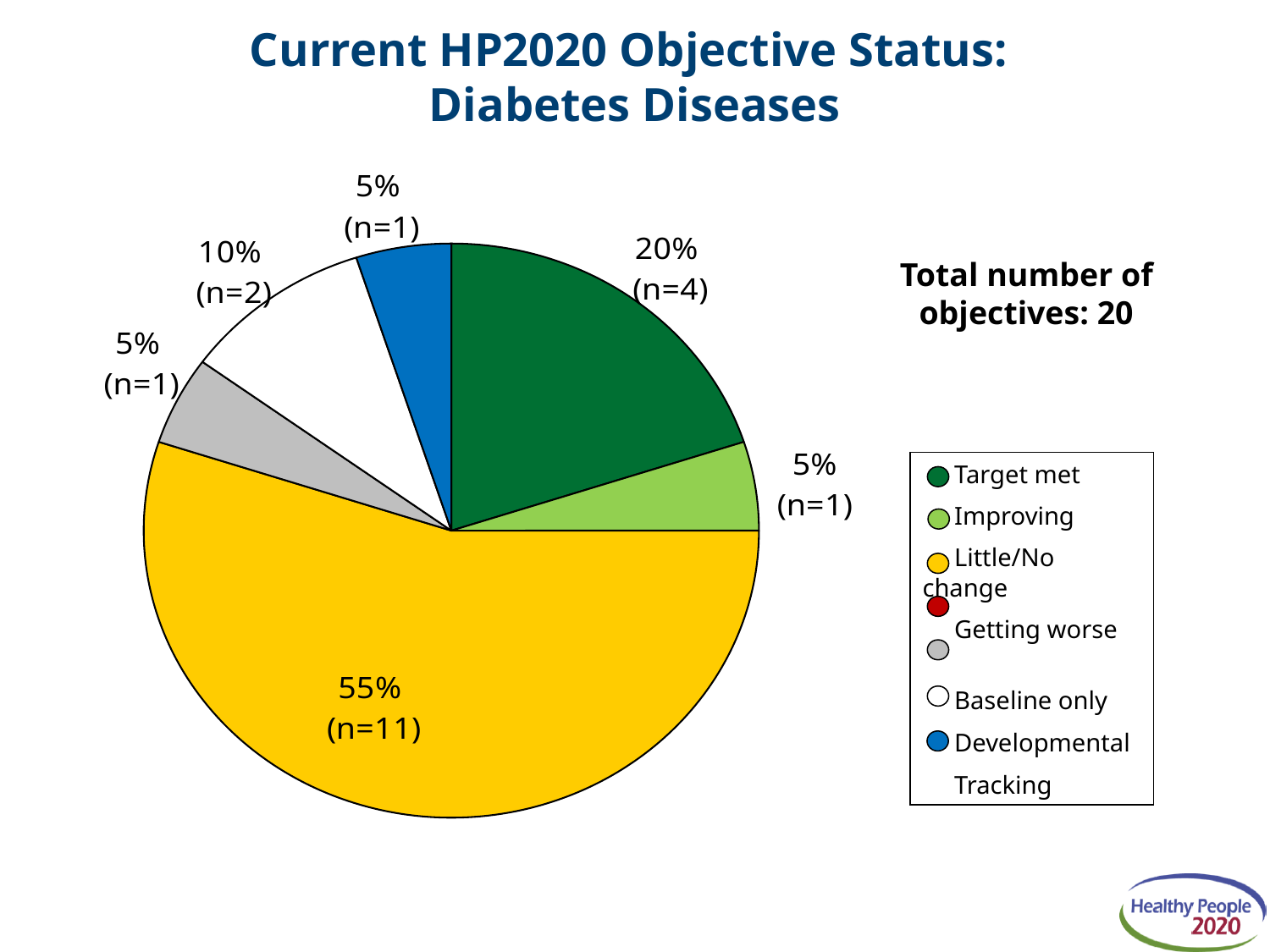
What is the title of the slide? Current HP2020 Objective Status: Diabetes Diseases What kind of chart is shown on the slide? Pie chart What percentage of objectives are Improving? 5% What percentage of objectives have the status Target met? 20% What is the total number of objectives stated on the slide? 20 Which has a larger share: Target met or Improving? Target met How many status categories does the legend list? 7 How many percentage points larger is the Little/No change share than the Target met share? 35 percentage points How many objectives (n) are in the Little/No change category? 11 What percentage of objectives are in the Little/No change category? 55% Which status category has the largest share of the pie? Little/No change How many objectives (n) have the status Target met? 4